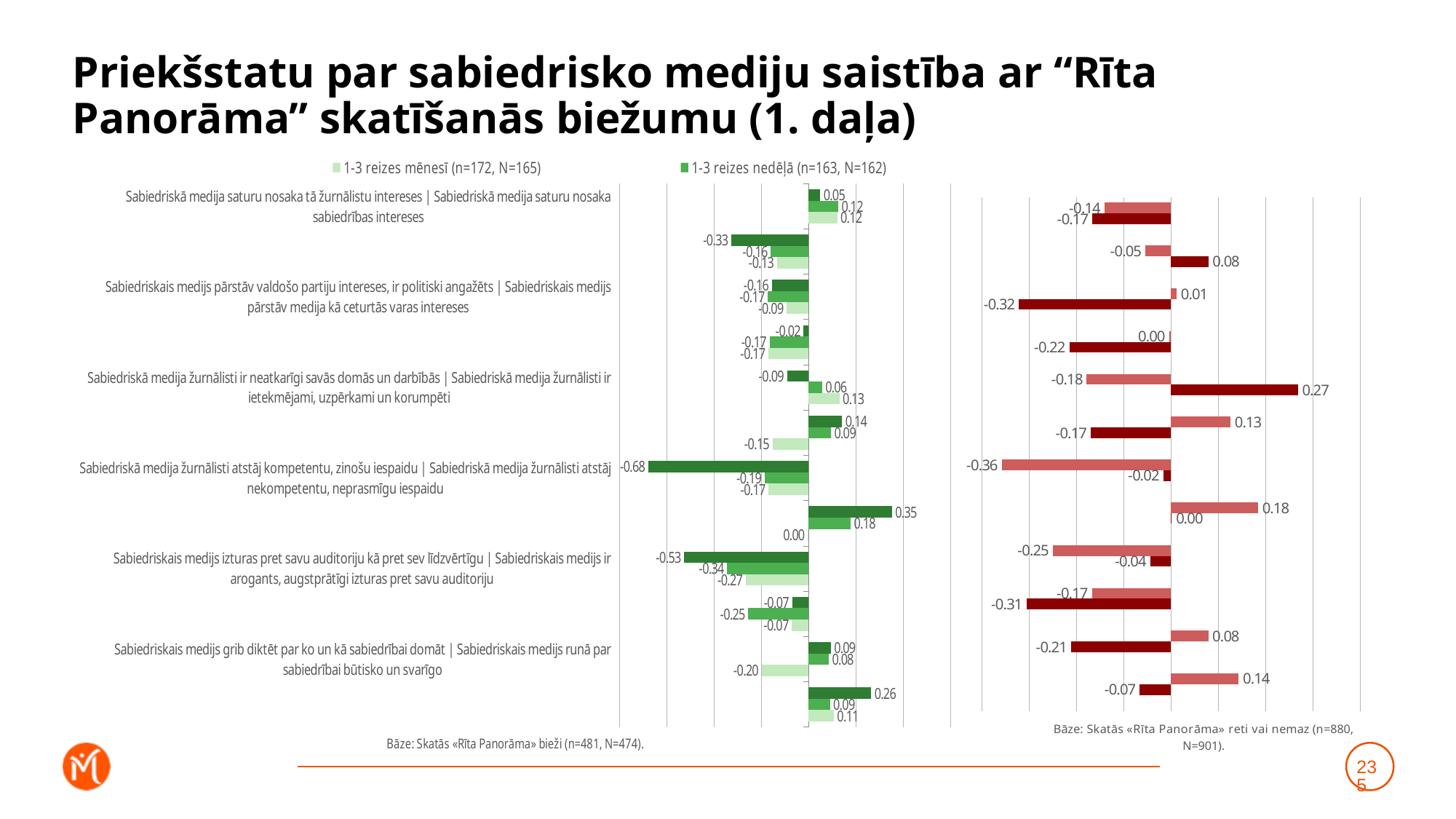
How many series does the legend at the top of the slide list? 2 What is the first legend entry shown above the charts? 1-3 reizes mēnesī (n=172, N=165) Which is larger: the highest labelled value in the left (green) chart or the highest labelled value in the right (red) chart? the left (green) chart In the right (red) chart, what is the lowest value labelled on any bar? -0.36 In the left (green) chart, what is the lowest value labelled on any bar? -0.68 What kind of chart is the left (green) chart on the slide? bar chart In the right (red) chart, what is the highest value labelled on any bar? 0.27 What base (Bāze) is stated below the left (green) chart? Skatās «Rīta Panorāma» bieži (n=481, N=474). How many category labels are listed along the left side of the charts? 6 What is the difference between the highest labelled value in the left (green) chart (0.35) and the highest labelled value in the right (red) chart (0.27)? 0.08 What kind of chart is the right (red) chart on the slide? bar chart In the left (green) chart, what is the highest value labelled on any bar? 0.35